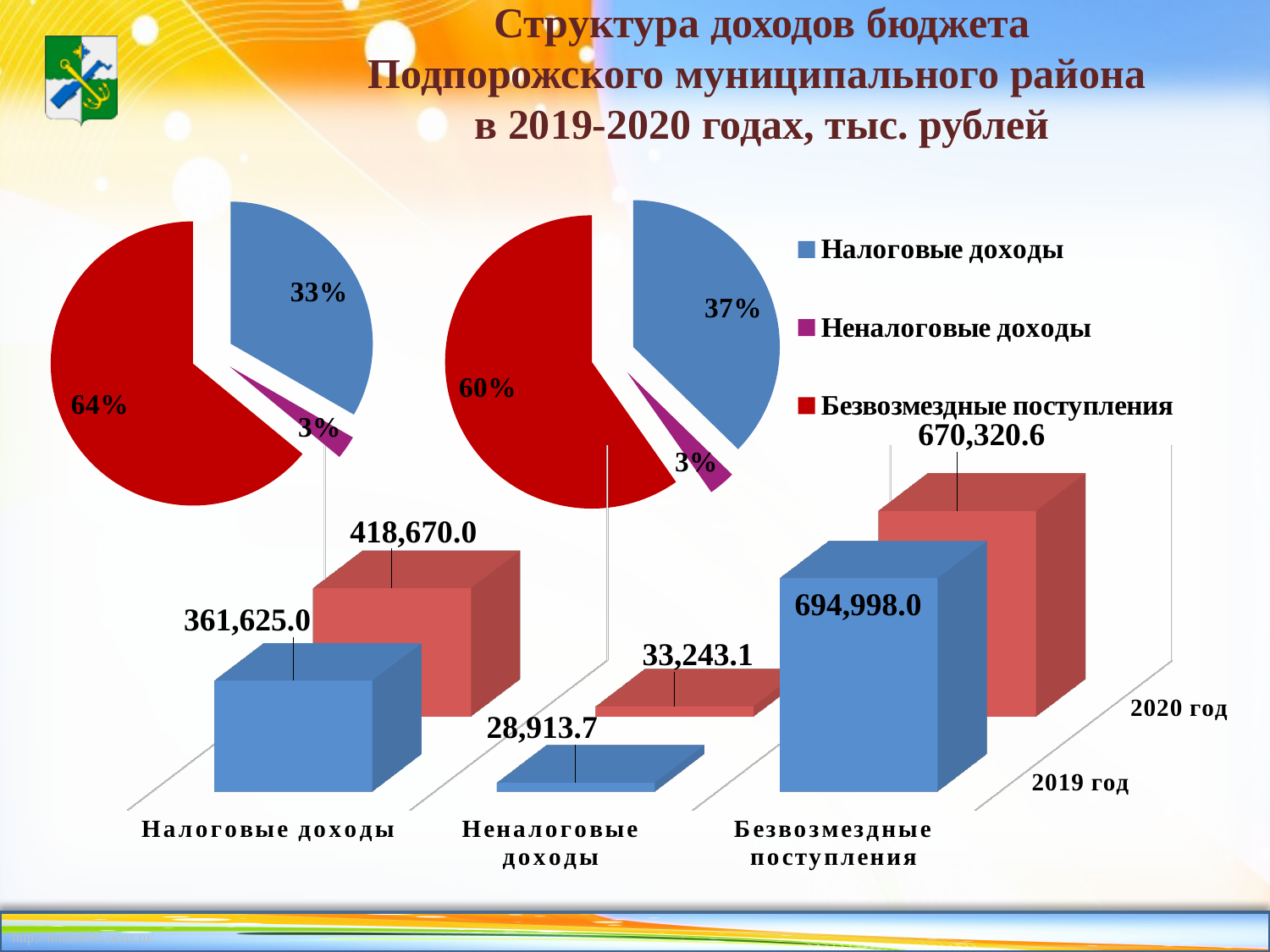
In the bar chart, what is the difference between Налоговые доходы in 2020 год and in 2019 год? 57,045.0 In the bar chart, what is the value for Неналоговые доходы in 2019 год? 28,913.7 How many entries does the legend list? 3 In the right pie chart, what share is shown for the red slice (Безвозмездные поступления)? 60% In the left pie chart, what share is shown for the blue slice (Налоговые доходы)? 33% In the bar chart, what is the value for Налоговые доходы in 2019 год? 361,625.0 In the bar chart, what is the value for Безвозмездные поступления in 2020 год? 670,320.6 In the bar chart, which category has the highest value in 2019 год? Безвозмездные поступления How many categories are shown on the x axis of the bar chart? 3 In the left pie chart, which category has the largest slice? Безвозмездные поступления In the bar chart, which is larger: Налоговые доходы in 2019 год or in 2020 год? 2020 год In the right pie chart, which category has the smallest slice? Неналоговые доходы